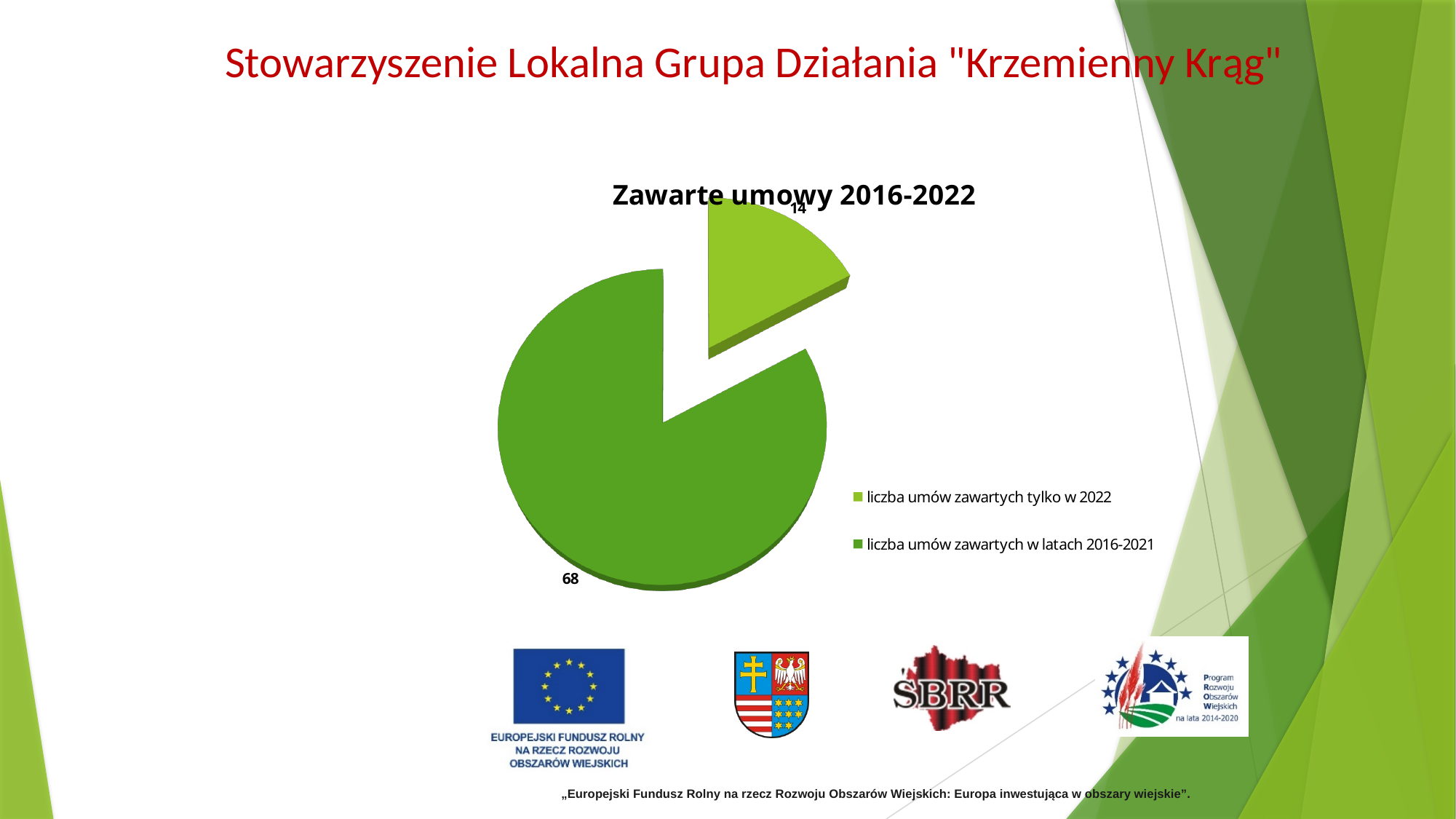
Which slice is shown in the lighter green colour? liczba umów zawartych tylko w 2022 How many entries does the legend list? 2 Which is larger: the value for 'liczba umów zawartych tylko w 2022' or for 'liczba umów zawartych w latach 2016-2021'? liczba umów zawartych w latach 2016-2021 How many slices does the pie chart have? 2 What is the value for 'liczba umów zawartych tylko w 2022'? 14 What is the difference between the number of contracts concluded in 2016-2021 and those concluded only in 2022? 54 What is the title of the chart? Zawarte umowy 2016-2022 Which category has the largest slice of the pie? liczba umów zawartych w latach 2016-2021 What is the total of the two slices in the pie chart? 82 Which category has the smallest slice of the pie? liczba umów zawartych tylko w 2022 What is the value for 'liczba umów zawartych w latach 2016-2021'? 68 What type of chart is shown on the slide? pie chart